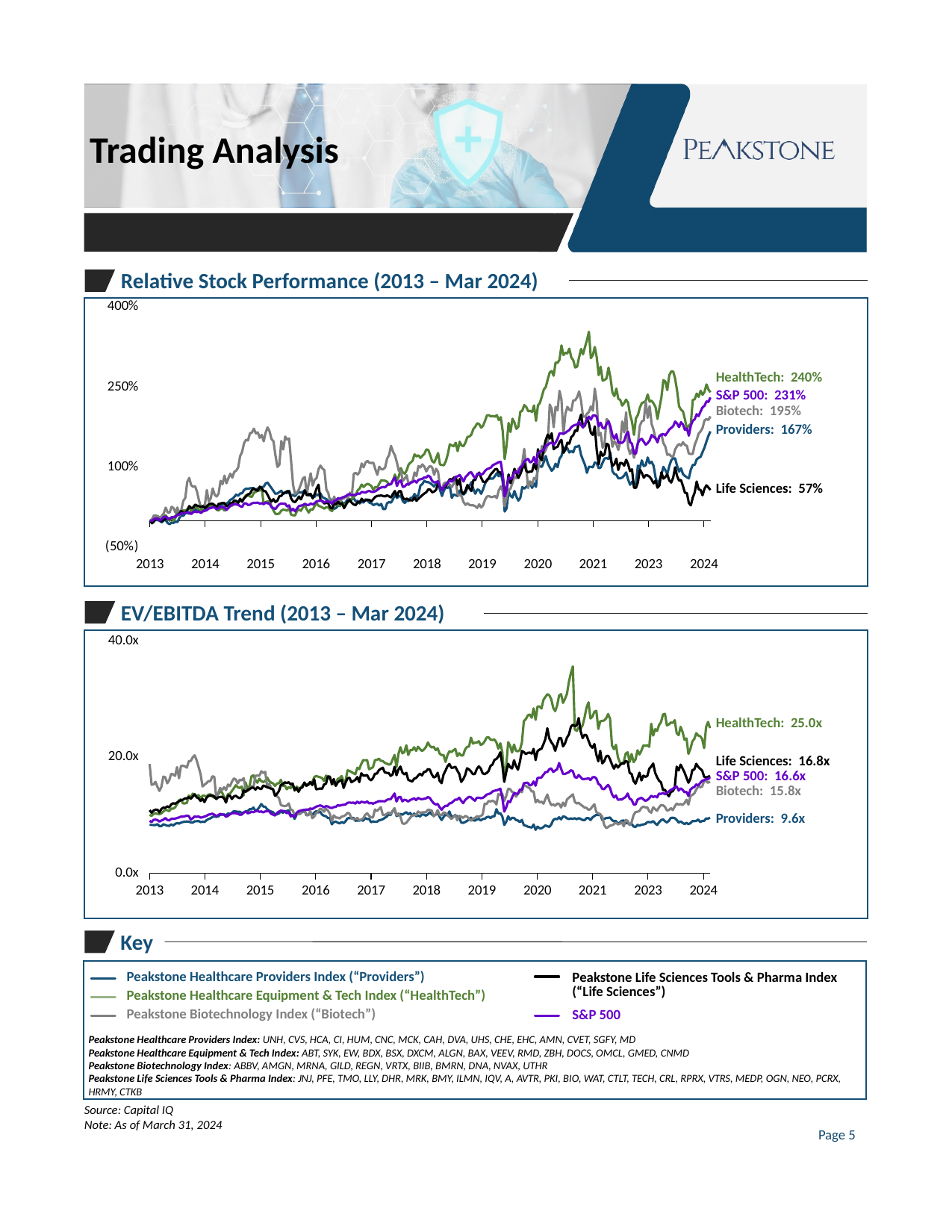
In the Relative Stock Performance chart, which has the higher final value, Providers or Biotech? Biotech In the EV/EBITDA Trend chart, what is the final value shown for Providers? 9.6x In the Relative Stock Performance chart, which index has the lowest final value? Life Sciences In the Relative Stock Performance chart, what is the final value shown for Life Sciences? 57% In the Relative Stock Performance chart, what is the final value shown for HealthTech? 240% What kind of chart is the Relative Stock Performance chart? Line chart In the EV/EBITDA Trend chart, what is the final value shown for S&P 500? 16.6x In the Relative Stock Performance chart, what is the difference between the final values for HealthTech and Biotech? 45% In the EV/EBITDA Trend chart, what is the difference between the final values for HealthTech and Providers? 15.4x How many series are plotted in the EV/EBITDA Trend chart? 5 In the EV/EBITDA Trend chart, is the final value for HealthTech greater or less than 20.0x? greater In the EV/EBITDA Trend chart, which index has the highest final value? HealthTech